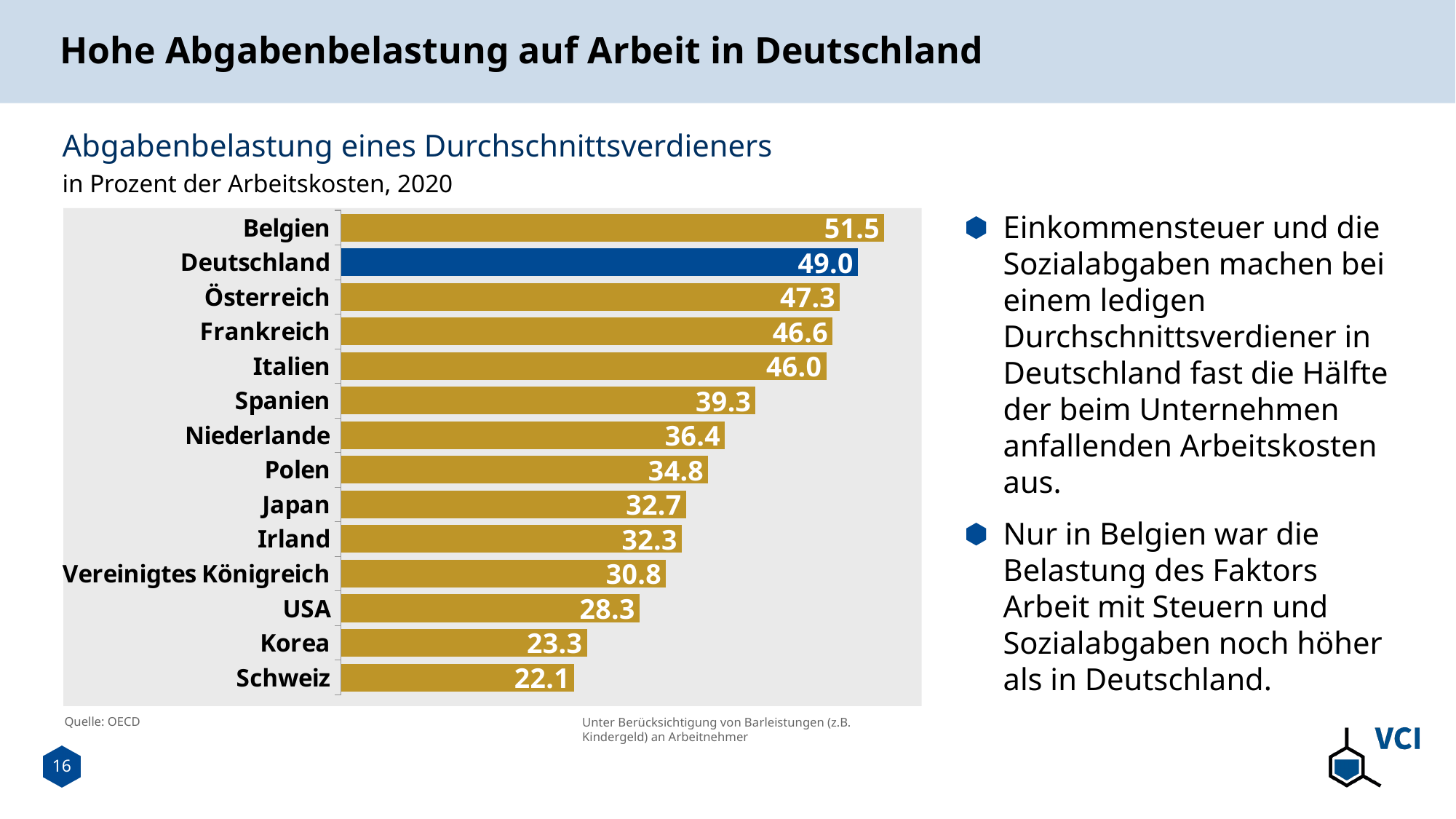
What kind of chart is shown on the slide? Bar chart What is the difference between the values for Belgien and Deutschland? 2.5 Which has a larger value, Japan or Irland? Japan What is the value for Spanien? 39.3 What is the difference between the values for USA and Korea? 5.0 Which country has the highest value? Belgien How many countries are shown in the chart? 14 Which has a larger value, Niederlande or Polen? Niederlande Which bar is highlighted in a different colour (blue) from the others? Deutschland Which country has the lowest value? Schweiz What is the value for Deutschland? 49.0 What is the value for Vereinigtes Königreich? 30.8